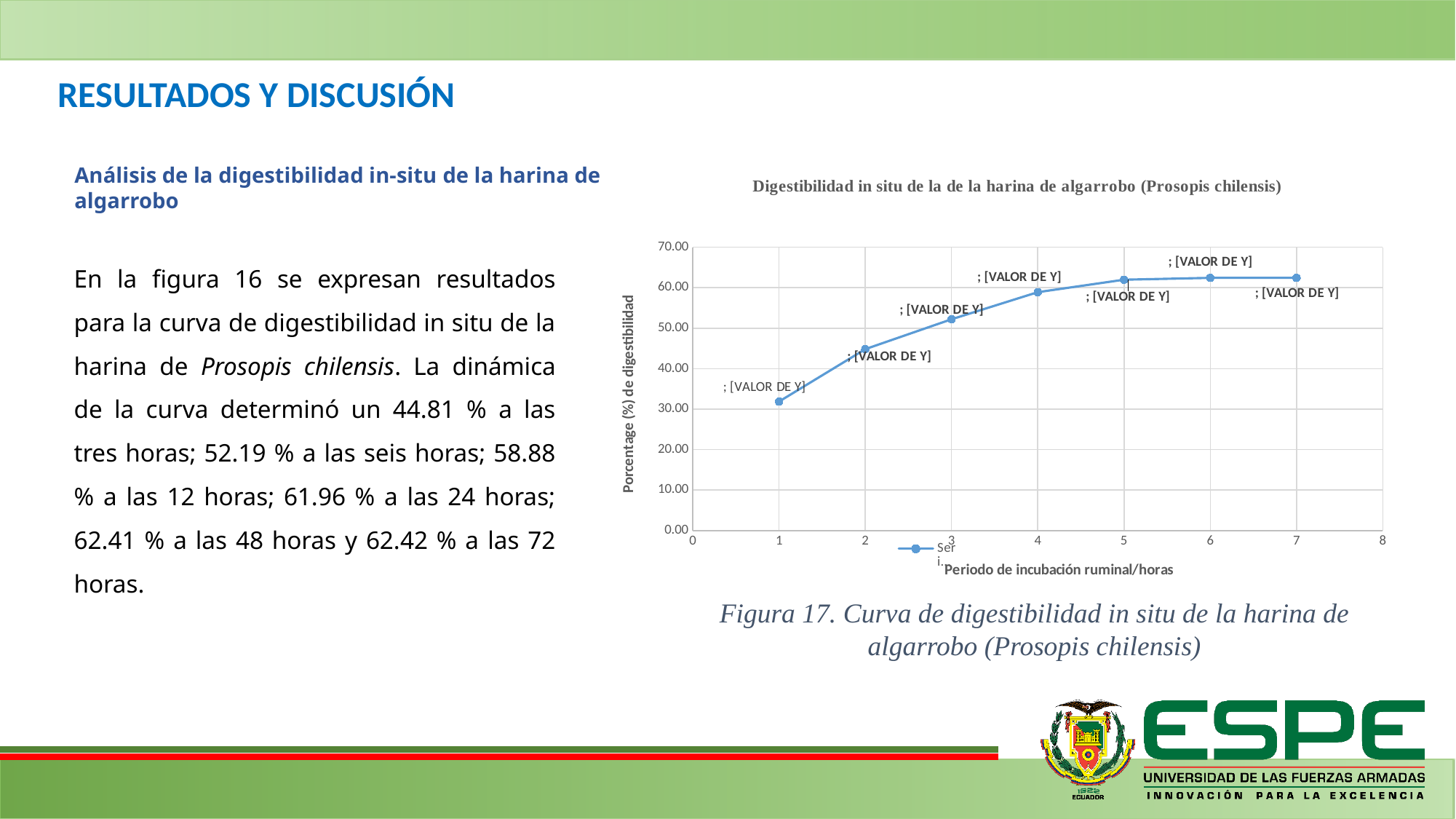
How many series does the chart's legend list? 1 What is the label of the chart's y axis? Porcentage (%) de digestibilidad How many data points are plotted on the line in the chart? 7 Is the value at x = 7 greater or less than 60? greater What kind of chart is shown on the slide? line chart Is the value at x = 1 greater or less than 40? less Which has the larger value on the chart, the point at x = 1 or the point at x = 4? x = 4 Do the values on the chart rise or fall as the x axis increases from 1 to 7? rise Which x-axis point has the lowest value on the chart? 1 What is the label of the chart's x axis? Periodo de incubación ruminal/horas Is the value at x = 2 greater or less than 40? greater